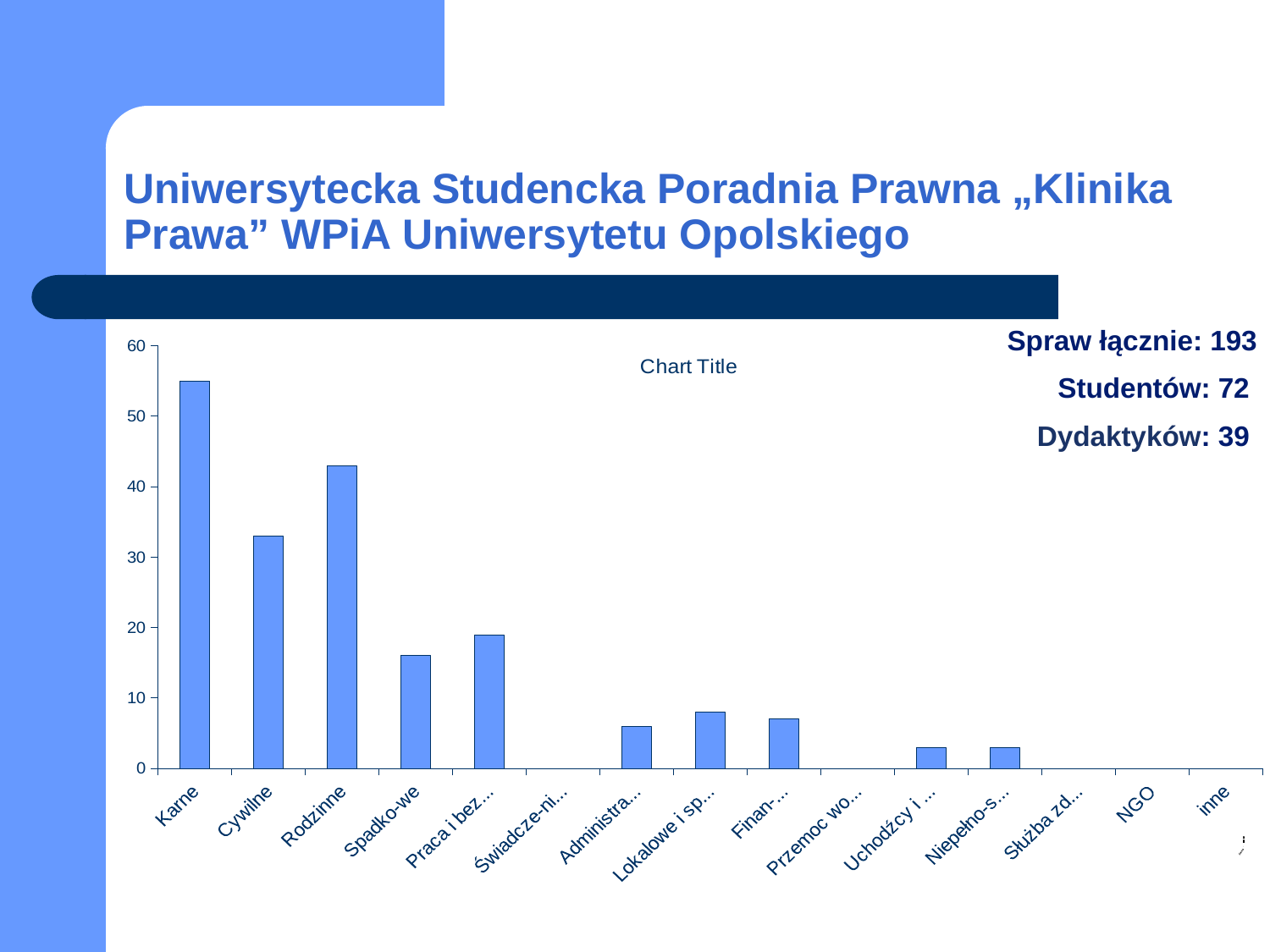
Is the value for Cywilne greater or less than 30? greater Is the value for Administra... greater or less than 10? less What title is printed on the chart? Chart Title Do the bars generally get taller or shorter moving from left to right along the x axis? shorter Is the value for Spadko-we greater or less than 20? less How many categories are shown on the x axis? 15 Which is larger, the value for Cywilne or the value for Rodzinne? Rodzinne What kind of chart is shown on the slide? bar chart Which is larger, the value for Karne or the value for Rodzinne? Karne Which category has the tallest bar? Karne